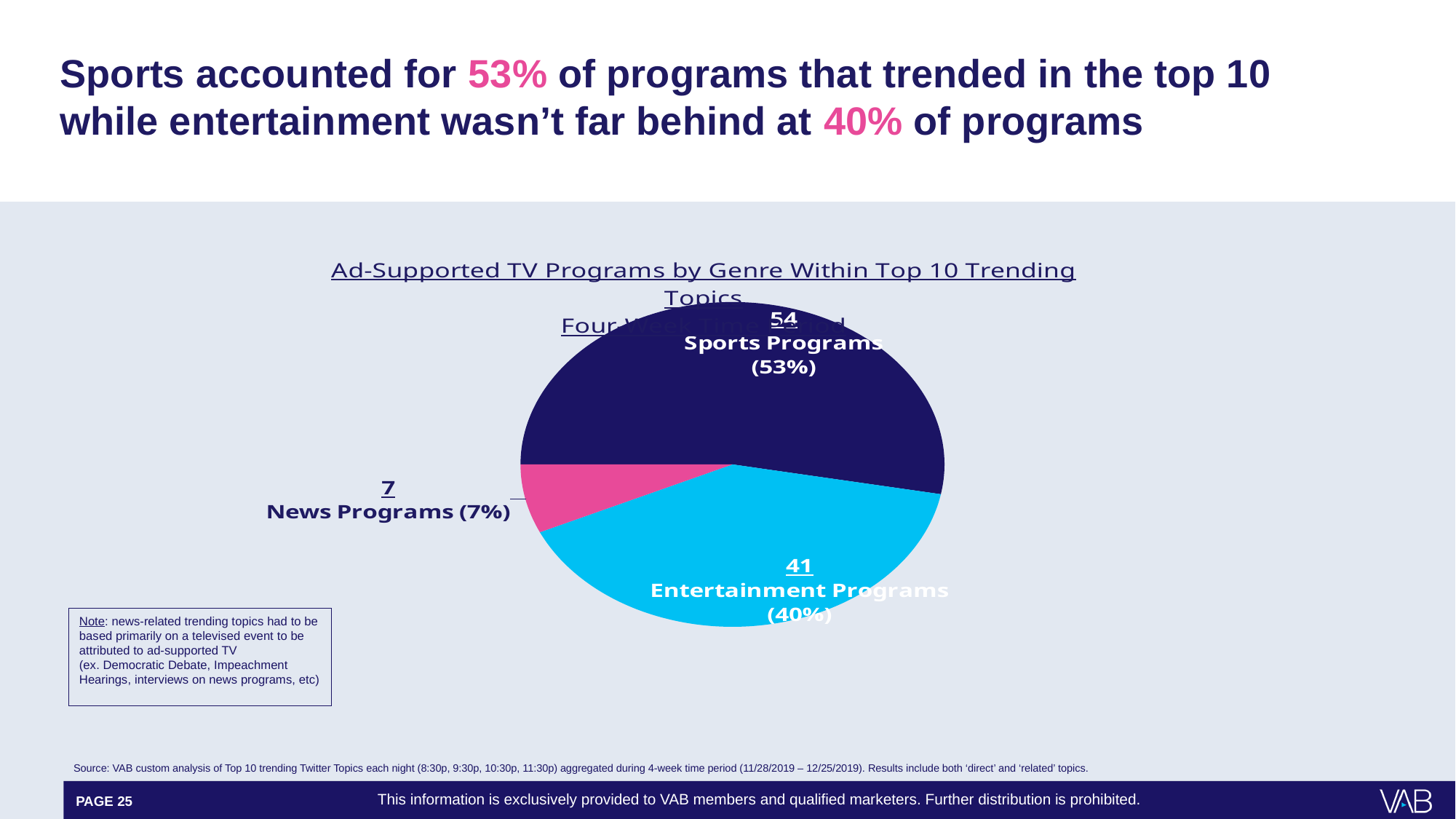
How many genre categories does the pie chart show? 3 How many programs are in the Sports Programs slice? 54 How many more programs are in the Sports Programs slice than in the Entertainment Programs slice? 13 Which genre has the smallest slice of the pie? News Programs Which genre has the largest slice of the pie? Sports Programs What share of the pie do Entertainment Programs account for? 40% Which slice is larger, Entertainment Programs or News Programs? Entertainment Programs How many programs are in the Entertainment Programs slice? 41 How many programs are in the News Programs slice? 7 What share of the pie do News Programs account for? 7% What kind of chart is shown on the slide? Pie chart What share of the pie do Sports Programs account for? 53%